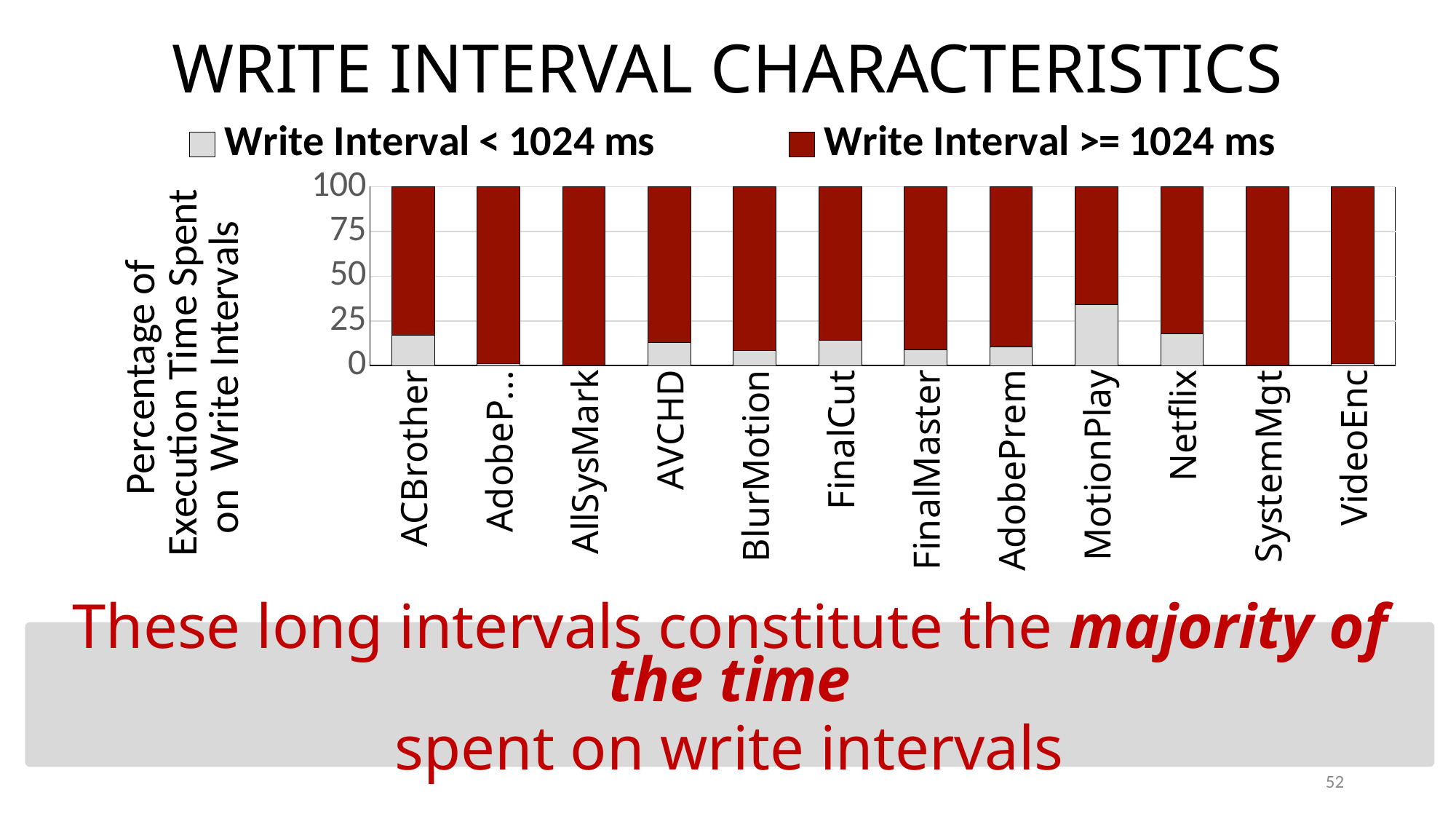
Which has a larger Write Interval < 1024 ms value, Netflix or BlurMotion? Netflix Is the Write Interval >= 1024 ms portion for MotionPlay greater or less than 50? greater What kind of chart is shown on the slide? Stacked bar chart What colour represents the Write Interval >= 1024 ms series? Dark red Is the Write Interval < 1024 ms value for ACBrother greater or less than 25? less Is the Write Interval < 1024 ms value for Netflix greater or less than 25? less Which has a larger Write Interval < 1024 ms value, MotionPlay or AVCHD? MotionPlay Which category has the largest share of execution time with Write Interval < 1024 ms? MotionPlay What is the total height of the stacked bar for FinalCut? 100 How many application categories are shown on the x axis? 12 How many series does the legend list? 2